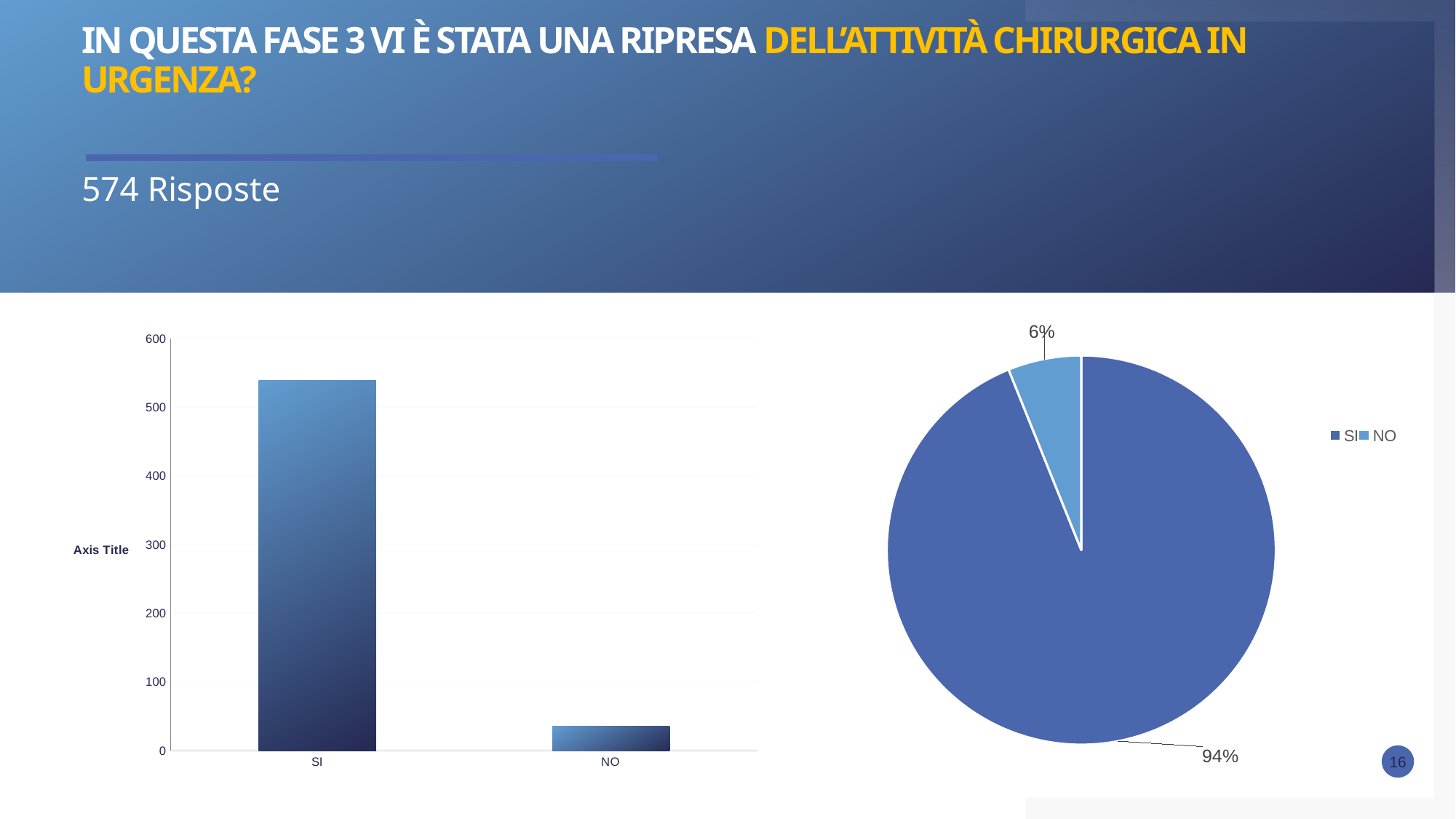
What kind of chart is on the right side of the slide? pie chart In the bar chart on the left, which category has the lowest value? NO In the pie chart on the right, what share does SI have? 94% In the bar chart on the left, how many categories are shown on the x axis? 2 In the pie chart on the right, what share does NO have? 6% In the bar chart on the left, which is larger, the value for SI or the value for NO? SI In the bar chart on the left, what is the highest value shown on the vertical axis? 600 What kind of chart is on the left side of the slide? bar chart In the pie chart on the right, how many entries does the legend list? 2 In the bar chart on the left, is the value for NO greater or less than 100? less In the bar chart on the left, is the value for SI greater or less than 500? greater In the bar chart on the left, which category has the highest value? SI